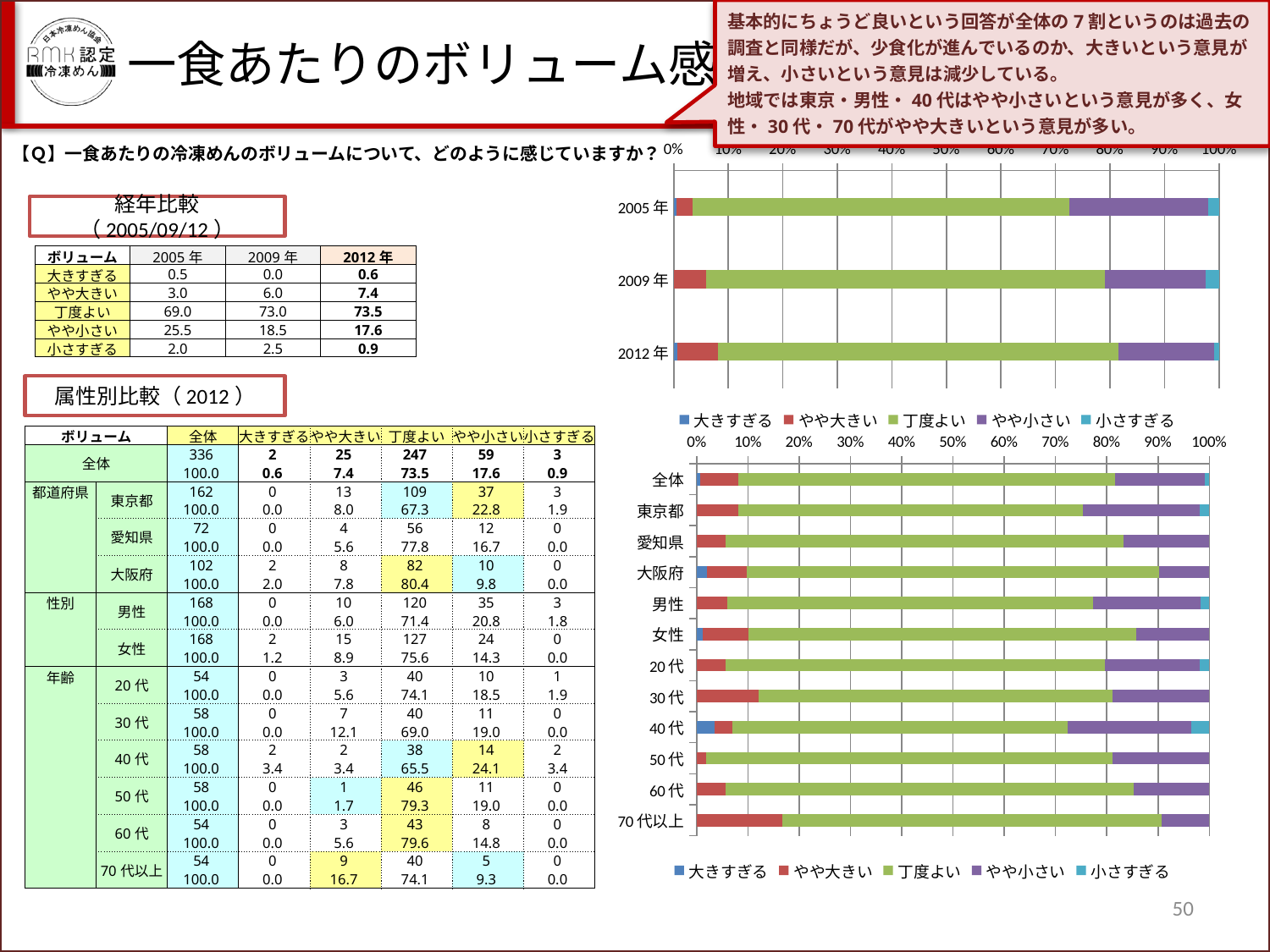
In the top chart, does the やや大きい segment rise or fall from 2005年 to 2012年? Rises In the bottom chart, which category has the smallest やや大きい segment? 50代 Which colour represents 丁度よい in the legend of the bottom chart? Green In the top chart, does the やや小さい segment rise or fall from 2005年 to 2012年? Falls In the top chart, is the combined 大きすぎる and やや大きい portion for 2012年 greater or less than 10%? less How many series does the legend of the bottom chart list? 5 How many year categories does the top chart show? 3 In the bottom chart, is the やや大きい segment for 70代以上 greater or less than 10%? greater How many categories are plotted on the bottom chart (属性別比較)? 12 In the bottom chart, which category has the largest やや大きい segment? 70代以上 In the bottom chart, which has the larger やや小さい segment, 東京都 or 愛知県? 東京都 What kind of chart is the top chart comparing 2005年, 2009年 and 2012年? Stacked bar chart